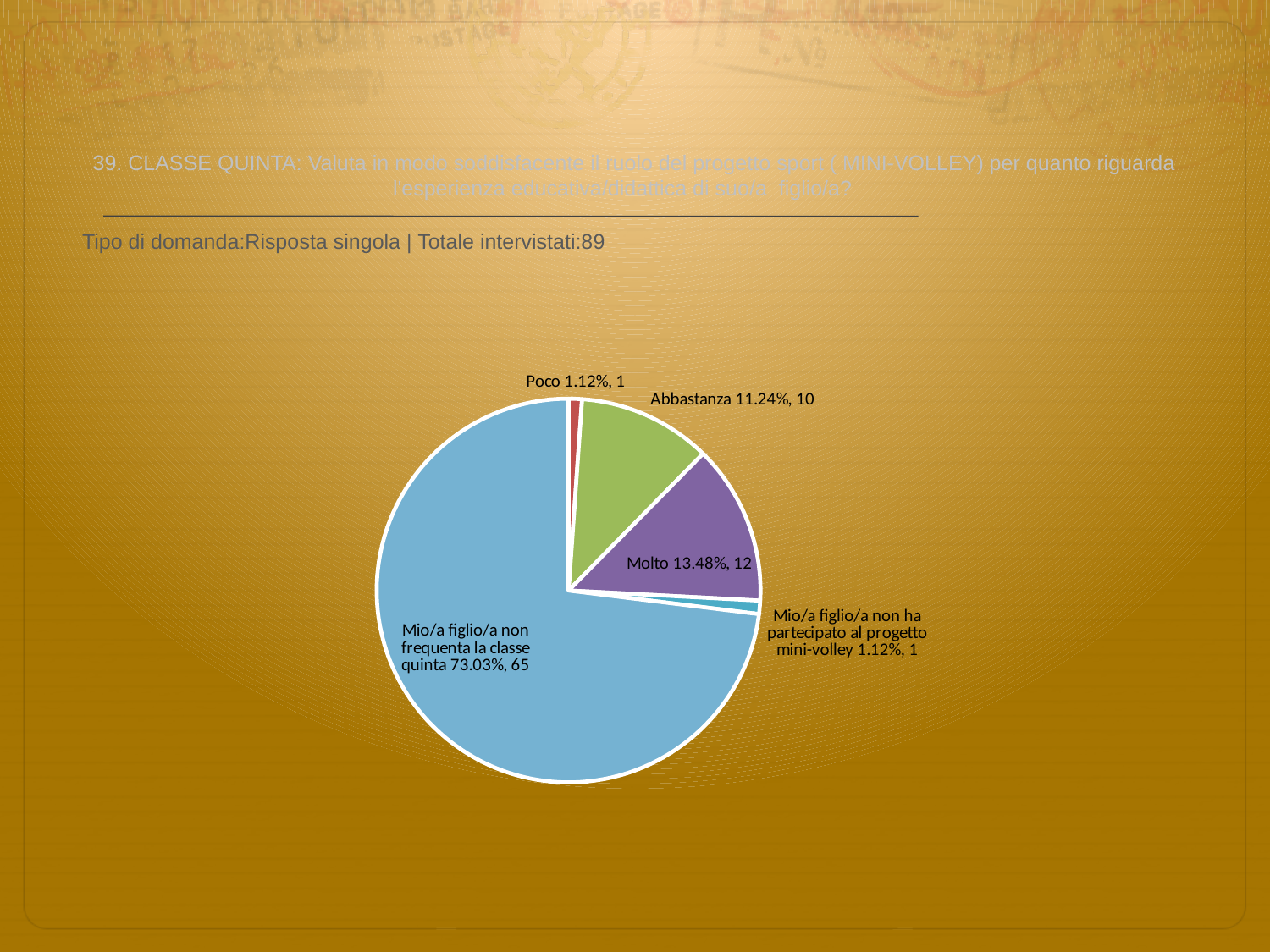
What is the difference in count between 'Molto' and 'Abbastanza'? 2 How many slices does the pie chart have? 5 What is the difference in count between 'Mio/a figlio/a non frequenta la classe quinta' and 'Molto'? 53 Which of the two is larger: 'Molto' or 'Abbastanza'? Molto What percentage share does the 'Molto' slice have? 13.48% What is the total number of respondents stated on the slide? 89 How many respondents answered 'Abbastanza'? 10 What percentage share does the 'Mio/a figlio/a non frequenta la classe quinta' slice have? 73.03% How many respondents answered 'Poco'? 1 What kind of chart is shown on the slide? pie chart Which category has the largest slice of the pie? Mio/a figlio/a non frequenta la classe quinta What percentage share does the 'Mio/a figlio/a non ha partecipato al progetto mini-volley' slice have? 1.12%